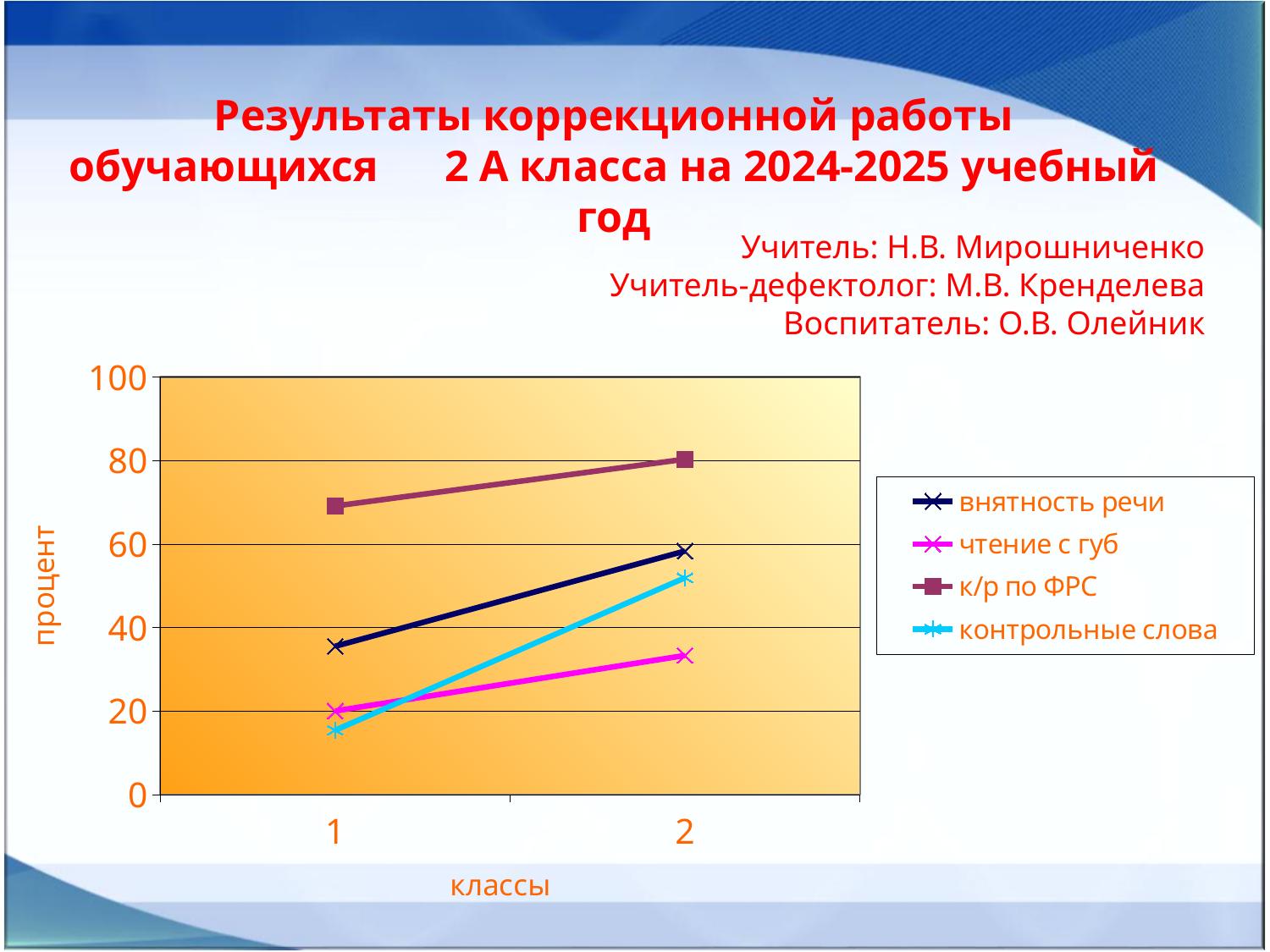
Is the value for контрольные слова at class 1 greater or less than 20? less Which series has the highest value at class 1? к/р по ФРС Is the value for внятность речи at class 2 greater or less than 40? greater How many categories are shown on the x axis? 2 What kind of chart is shown on the slide? line chart How many series does the legend list? 4 Which series has the lowest value at class 1? контрольные слова At class 2, which is larger: внятность речи or контрольные слова? внятность речи Which series has the highest value at class 2? к/р по ФРС What is the title of the vertical axis? процент Does the value for внятность речи rise or fall from class 1 to class 2? rise Which series has the lowest value at class 2? чтение с губ